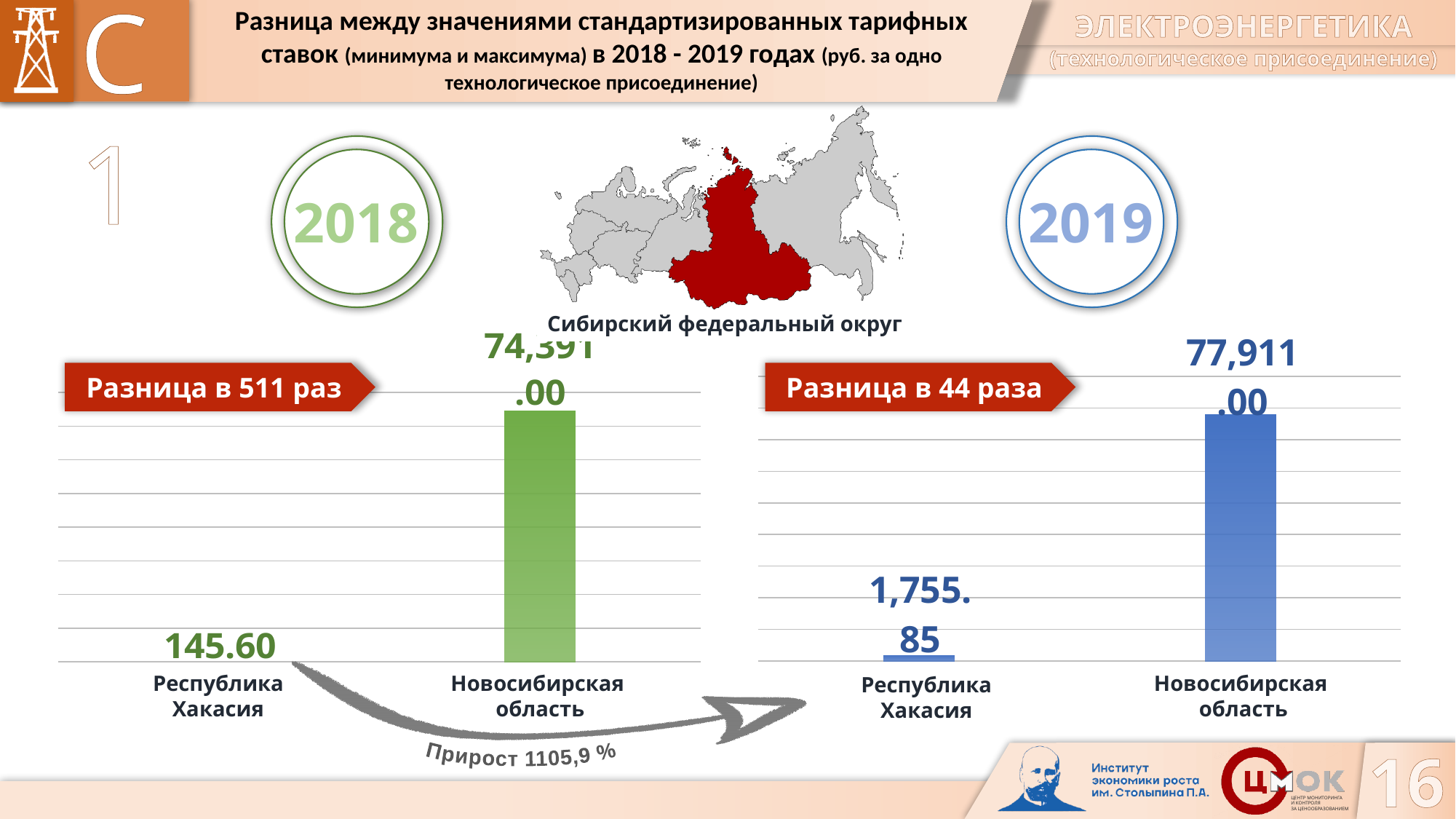
In the 2019 chart, what is the difference between the values for Новосибирская область and Республика Хакасия? 76,155.15 What type of chart is the 2018 chart? Bar chart In the 2019 chart, what is the value for Республика Хакасия? 1,755.85 Which is larger: the value for Республика Хакасия in the 2018 chart or in the 2019 chart? 2019 How many categories are shown in the 2019 chart? 2 What colour are the bars in the 2018 chart? Green How many charts are on the slide? 2 In the 2019 chart, which category has the highest value? Новосибирская область In the 2018 chart, which category has the lowest value? Республика Хакасия In the 2019 chart, what is the value for Новосибирская область? 77,911.00 What does the red callout label above the 2019 chart say? Разница в 44 раза In the 2018 chart, what is the value for Республика Хакасия? 145.60